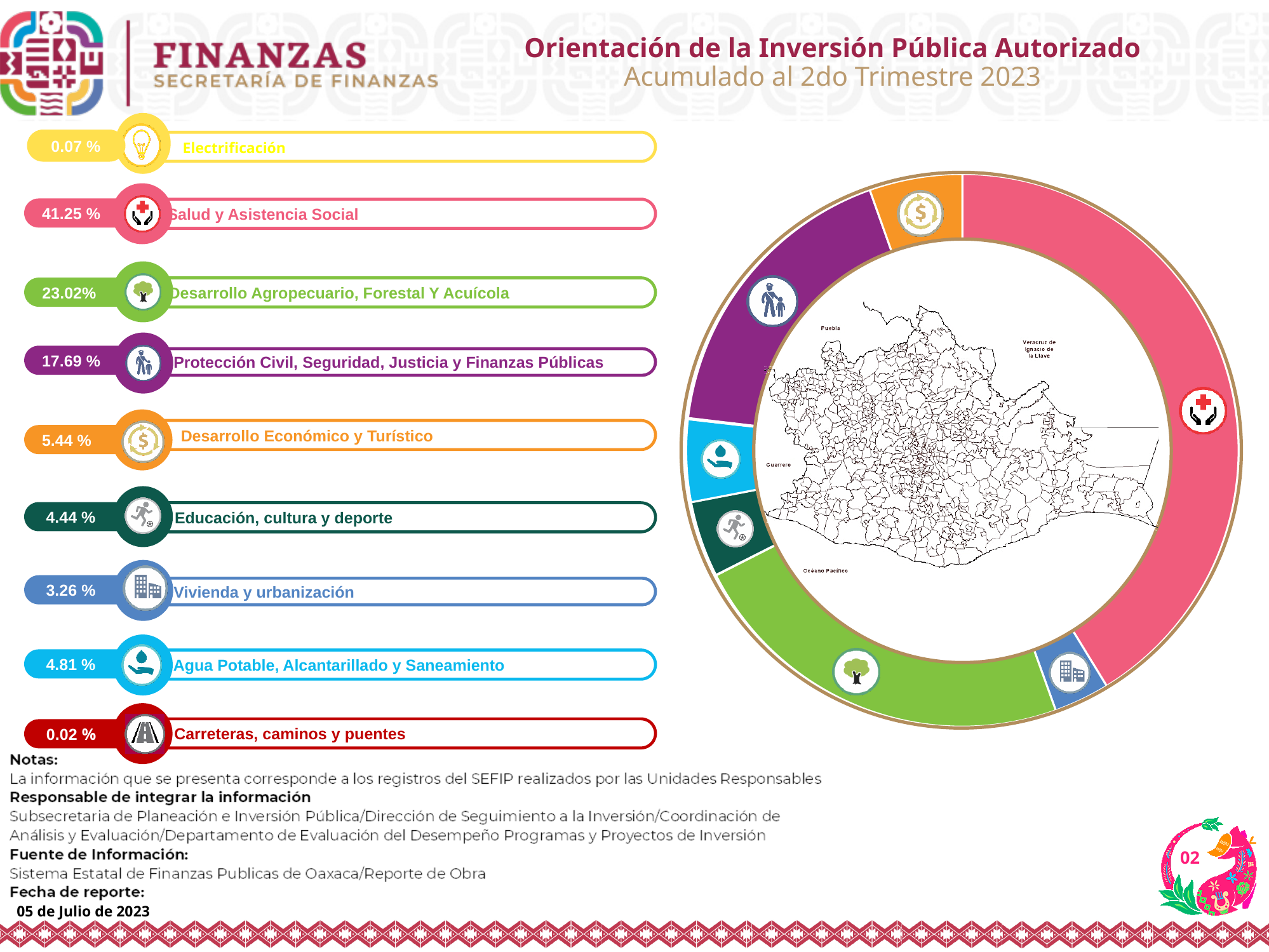
What percentage is shown for Protección Civil, Seguridad, Justicia y Finanzas Públicas? 17.69 % What share of authorized public investment goes to Salud y Asistencia Social? 41.25 % What is the title of the slide's chart? Orientación de la Inversión Pública Autorizado Acumulado al 2do Trimestre 2023 Which has a larger share: Agua Potable, Alcantarillado y Saneamiento or Educación, cultura y deporte? Agua Potable, Alcantarillado y Saneamiento How many investment categories are listed on the slide? 9 Which category has the largest share of authorized public investment? Salud y Asistencia Social What percentage is shown for Carreteras, caminos y puentes? 0.02 % What is the difference in percentage points between Salud y Asistencia Social and Desarrollo Agropecuario, Forestal Y Acuícola? 18.23 What percentage is shown for Agua Potable, Alcantarillado y Saneamiento? 4.81 % What kind of chart is shown on the right side of the slide? Donut (pie) chart Which category has the smallest share of authorized public investment? Carreteras, caminos y puentes What percentage is shown for Desarrollo Agropecuario, Forestal Y Acuícola? 23.02%